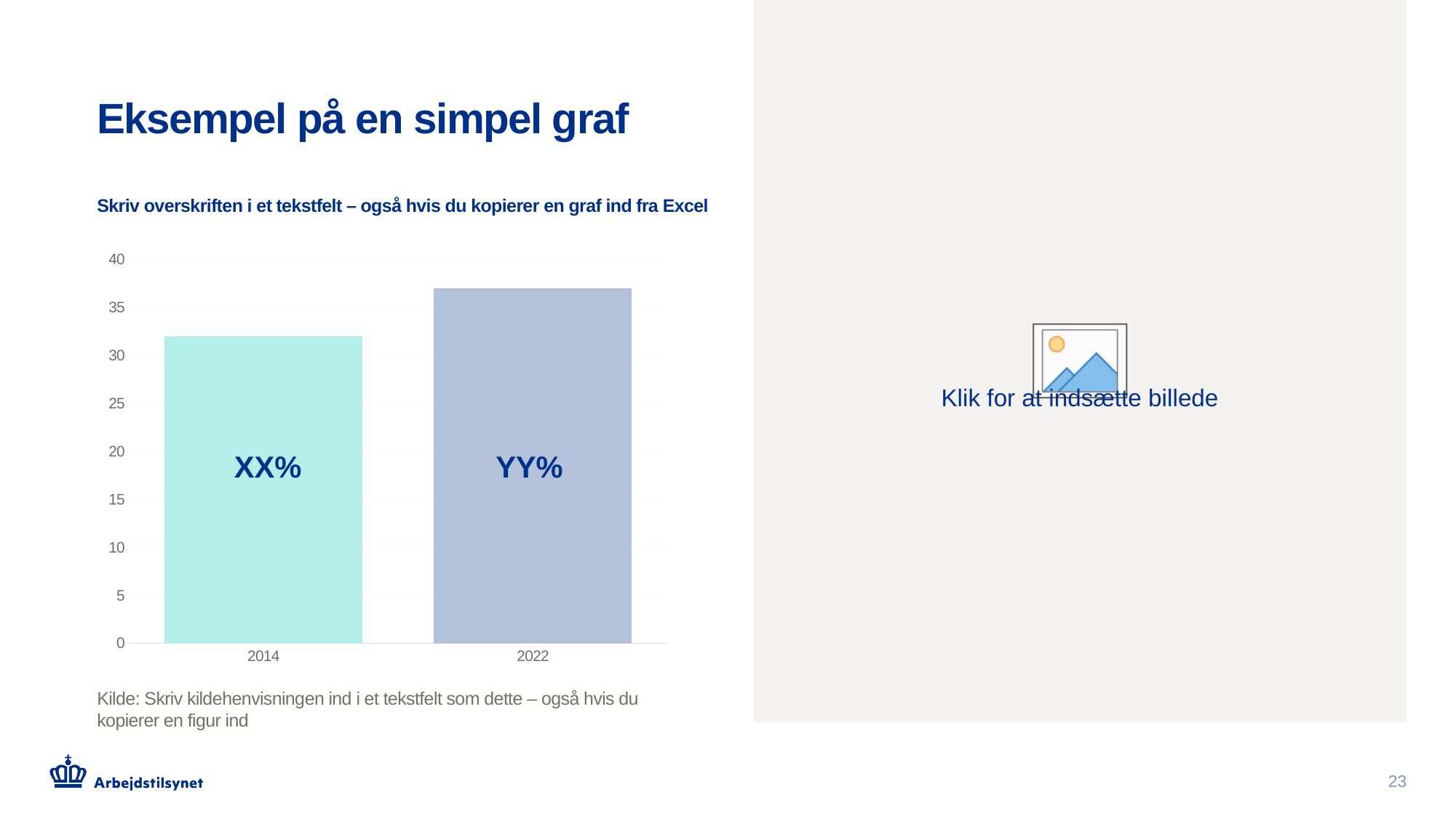
Is the value for 2014 greater or less than 35? less Is the value for 2014 greater or less than 30? greater Is the value for 2022 greater or less than 40? less Which year has the lowest bar in the chart? 2014 Do the values rise or fall from 2014 to 2022? rise What text label is printed on the 2014 bar? XX% Which bar is taller, 2014 or 2022? 2022 What kind of chart is shown on the slide? bar chart What is the highest value shown on the vertical axis of the chart? 40 How many bars does the chart show? 2 Which year has the highest bar in the chart? 2022